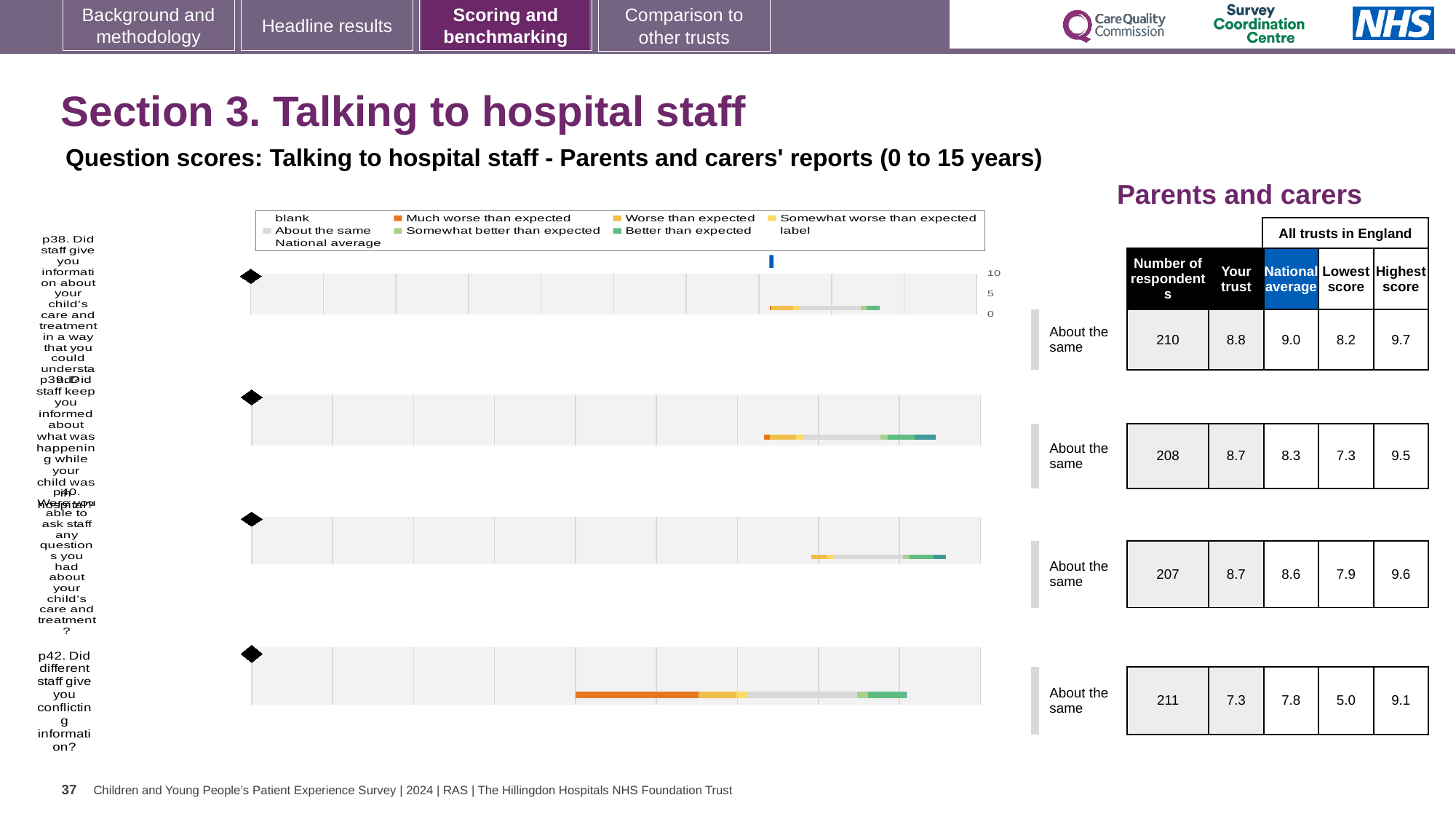
How many question charts (p38, p39, p40, p42) are shown on the slide? 4 How many entries does the shared legend above the charts list? 9 In the table to the right of the charts, what is the 'National average' for p39? 8.3 In the table to the right of the charts, which question has the lowest 'Your trust' score? p42 What is the highest tick value shown on the axis of the first (p38) chart? 10 In the table to the right of the charts, how many respondents are listed for p38? 210 In the table to the right of the charts, which is larger for p42: the 'Your trust' score or the 'National average'? National average What kind of chart is used to show the question scores for p38? bar chart What colour does the legend use for 'Much worse than expected'? orange In the table to the right of the charts, what is the 'Your trust' score for p42 (Did different staff give you conflicting information?)? 7.3 In the table to the right of the charts, what is the difference between the highest score (9.7) and the lowest score (8.2) for p38? 1.5 What benchmark label is printed beside each of the four charts? About the same